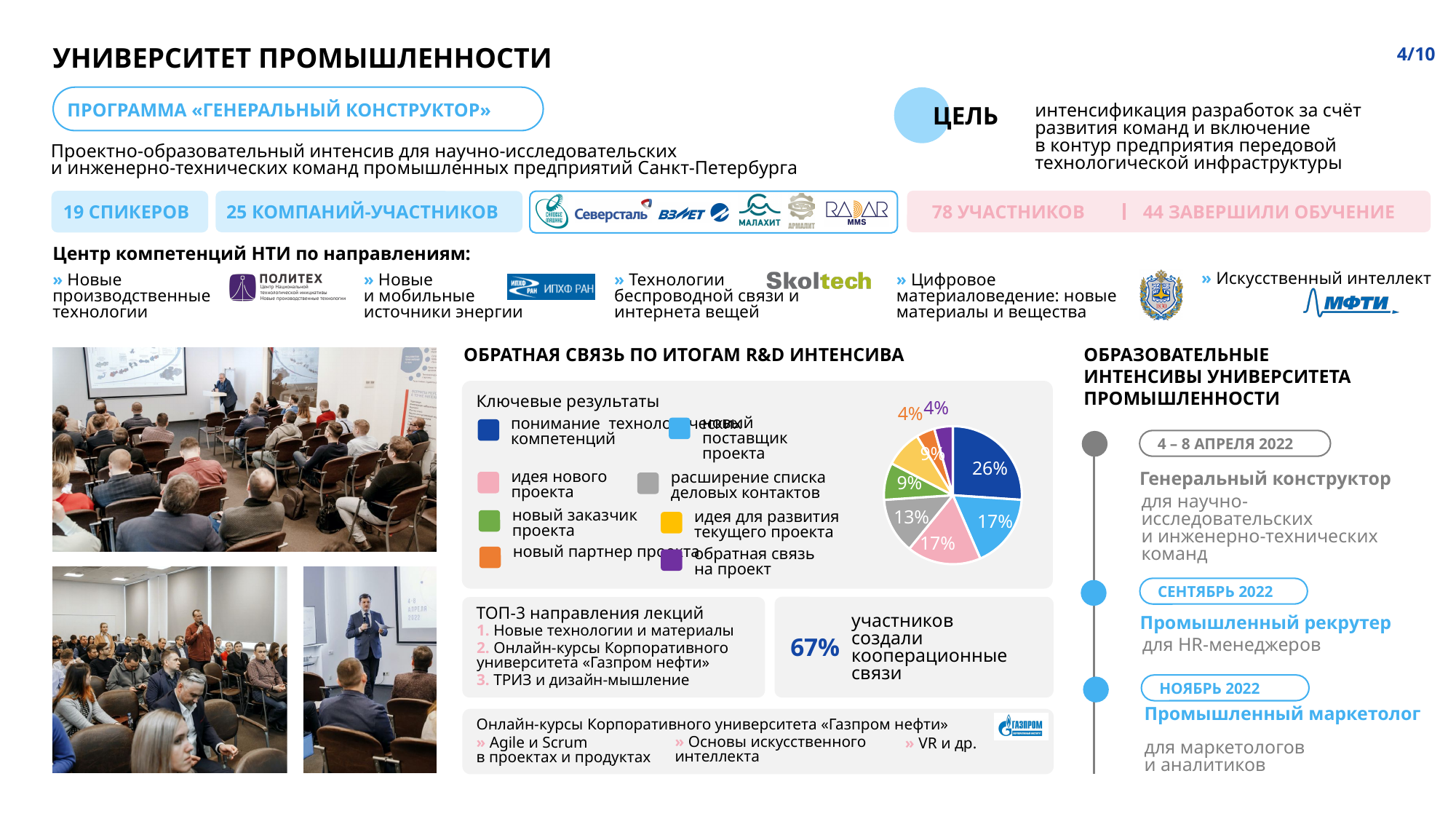
In the «Ключевые результаты» pie chart, which category has the largest share? понимание технологических компетенций In the «Ключевые результаты» pie chart, what is the share for «расширение списка деловых контактов»? 13% In the «Ключевые результаты» pie chart, which is larger: the share for «новый поставщик проекта» or the share for «новый заказчик проекта»? новый поставщик проекта What kind of chart is shown under «Ключевые результаты» in the «Обратная связь по итогам R&D интенсива» section? pie chart How many slices does the «Ключевые результаты» pie chart have? 8 In the «Ключевые результаты» pie chart, what colour is the slice for «идея для развития текущего проекта»? yellow In the «Ключевые результаты» pie chart, what is the largest share value shown? 26% In the «Ключевые результаты» pie chart, what is the share for «обратная связь на проект»? 4% In the «Ключевые результаты» pie chart, what is the difference between the share for «понимание технологических компетенций» and the share for «расширение списка деловых контактов»? 13% In the «Ключевые результаты» pie chart, how many slices are labelled 4%? 2 In the «Ключевые результаты» pie chart, what is the share for «идея нового проекта»? 17% In the «Ключевые результаты» pie chart, what is the share for «новый заказчик проекта»? 9%